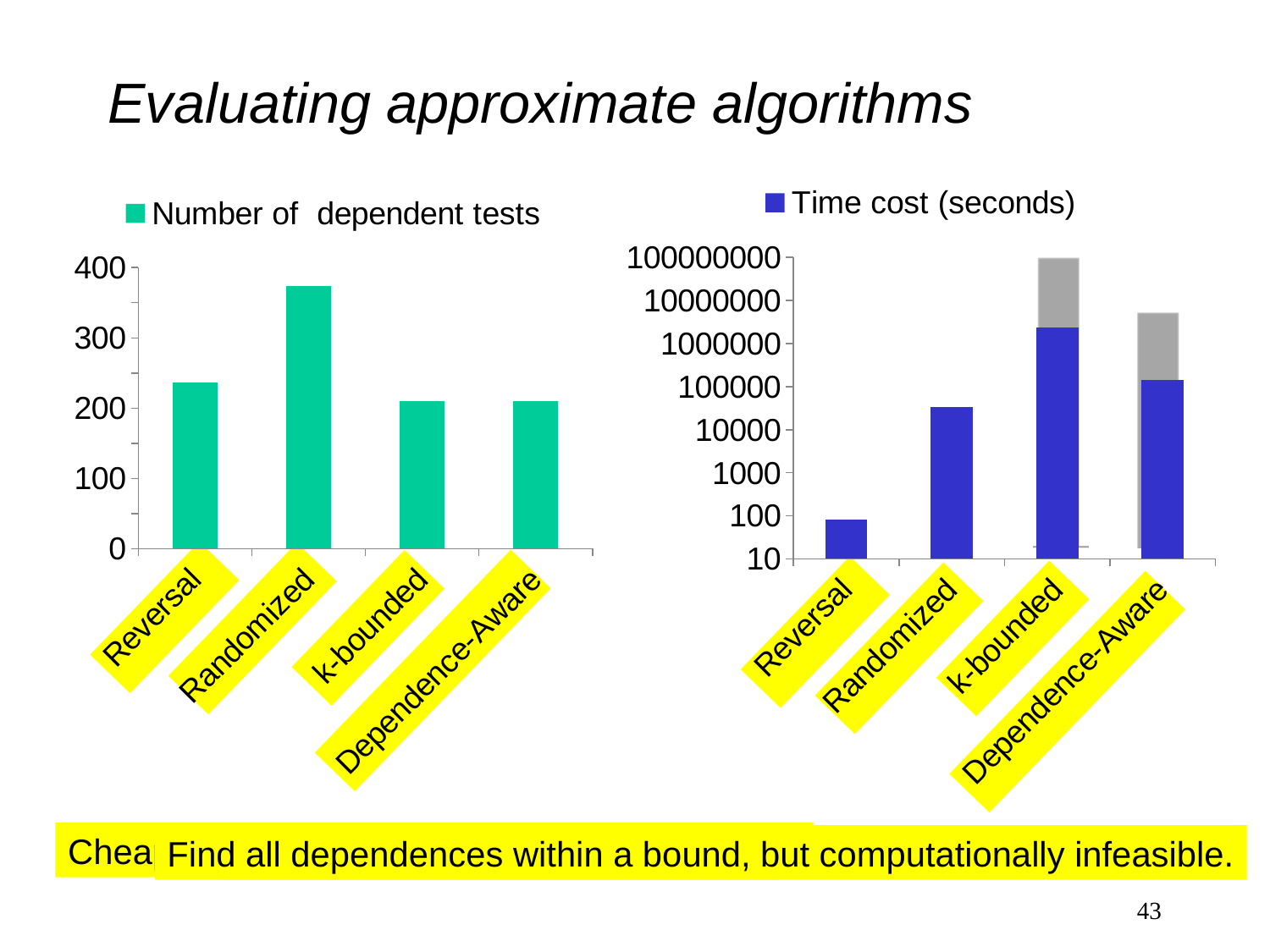
In the 'Time cost (seconds)' chart, which category has the lowest time cost? Reversal In the 'Number of dependent tests' chart, which category has the highest value? Randomized What kind of chart is the 'Number of dependent tests' chart? bar chart In the 'Number of dependent tests' chart, is the value for Reversal greater or less than 300? less In the 'Number of dependent tests' chart, is the value for Randomized greater or less than 300? greater In the 'Time cost (seconds)' chart, which is larger, the value for Randomized or the value for Reversal? Randomized In the 'Number of dependent tests' chart, which is larger, the value for Randomized or the value for Reversal? Randomized How many series does the legend of the 'Time cost (seconds)' chart list? 1 In the 'Time cost (seconds)' chart, which category has the highest bar? k-bounded How many categories are shown in the 'Number of dependent tests' chart? 4 In the 'Time cost (seconds)' chart, is the value for Randomized greater or less than 10000? greater